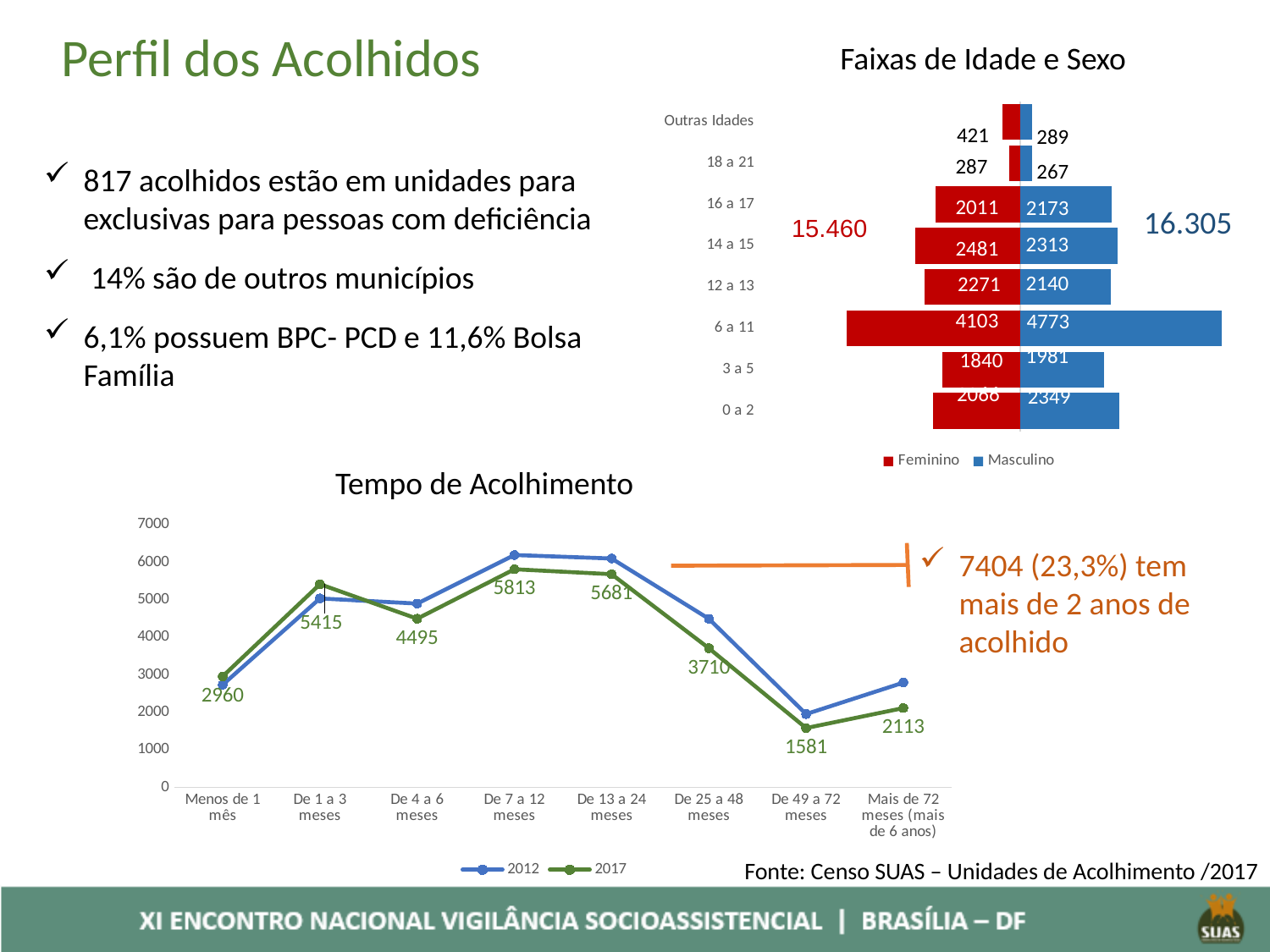
In the 'Faixas de Idade e Sexo' chart, what is the total shown for Feminino? 15.460 How many series does the legend of the 'Faixas de Idade e Sexo' chart list? 2 What kind of chart is the 'Faixas de Idade e Sexo' chart? bar chart In the 'Faixas de Idade e Sexo' chart, what is the Feminino value for the 6 a 11 age group? 4103 In the 'Faixas de Idade e Sexo' chart, which is larger for the 14 a 15 age group, Feminino or Masculino? Feminino In the 'Faixas de Idade e Sexo' chart, what is the Masculino value for the 16 a 17 age group? 2173 In the 'Faixas de Idade e Sexo' chart, which age group has the highest Masculino value? 6 a 11 In the 'Tempo de Acolhimento' chart, what is the 2017 value for 'De 49 a 72 meses'? 1581 In the 'Faixas de Idade e Sexo' chart, what is the difference between the Masculino and Feminino values for the 6 a 11 age group? 670 In the 'Tempo de Acolhimento' chart, is the 2012 value for 'De 7 a 12 meses' greater or less than 6000? greater How many categories are shown on the x axis of the 'Tempo de Acolhimento' chart? 8 What kind of chart is the 'Tempo de Acolhimento' chart? line chart